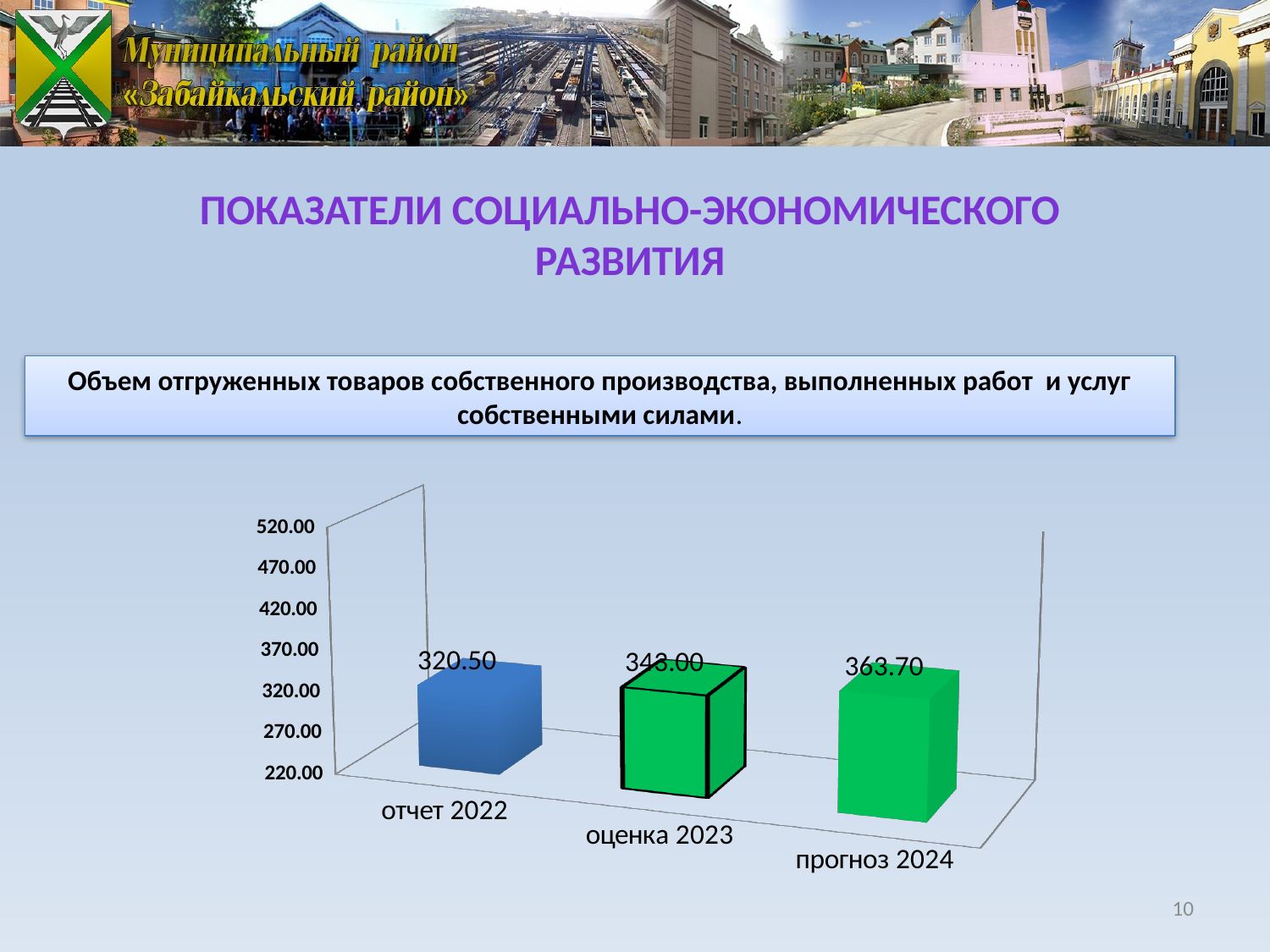
Which category has the lowest value? отчет 2022 What colour is the bar for отчет 2022? blue What is the value for отчет 2022? 320.50 Which category has the highest value? прогноз 2024 How many categories are shown on the x axis? 3 What is the value for прогноз 2024? 363.70 Is the value for оценка 2023 greater or less than 320.00? greater What is the difference between the values for прогноз 2024 and отчет 2022? 43.20 Is the value for отчет 2022 greater or less than 370.00? less Do the values rise or fall from отчет 2022 to прогноз 2024? rise What kind of chart is shown on the slide? bar chart Which is larger, the value for прогноз 2024 or the value for отчет 2022? прогноз 2024